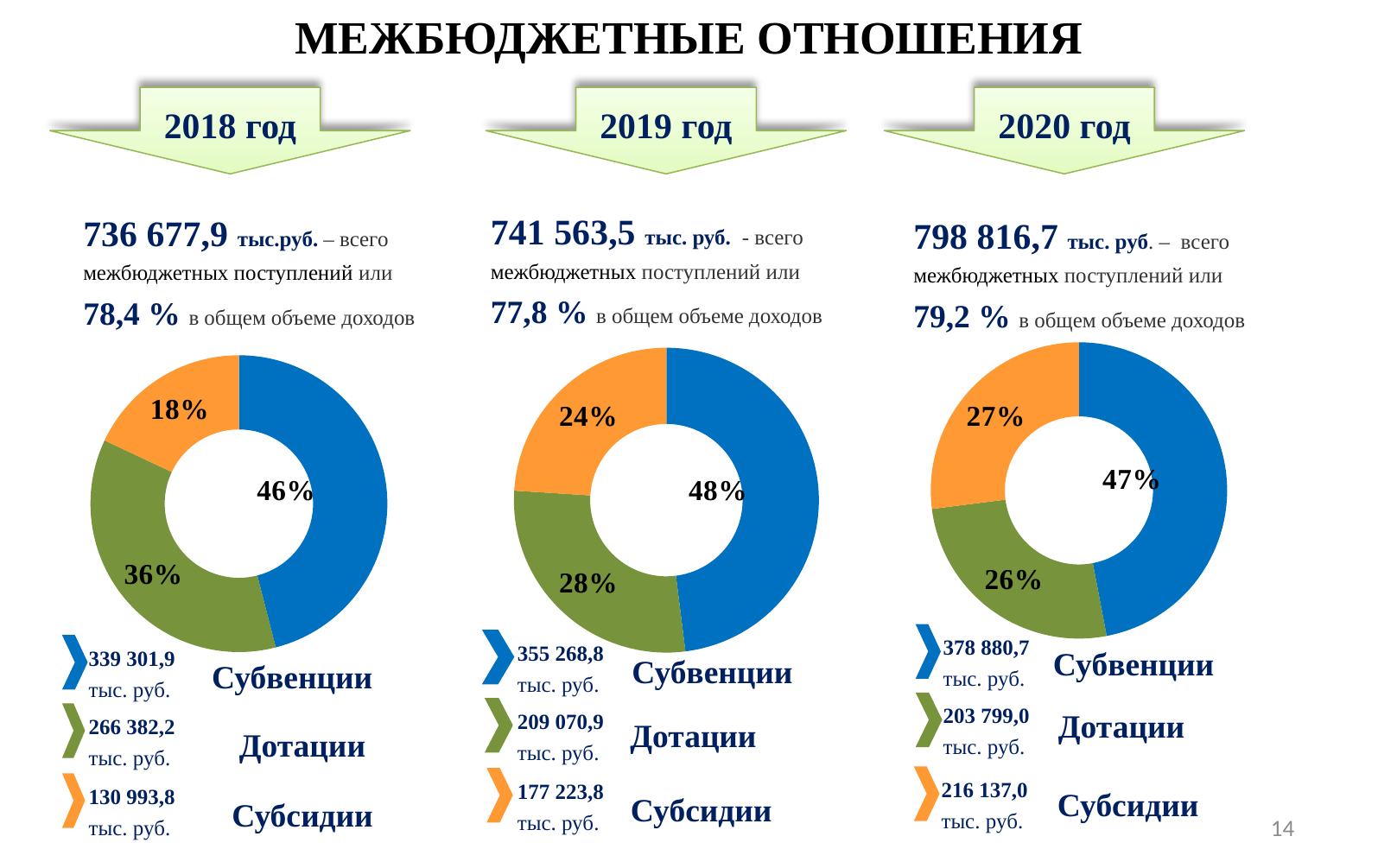
In the 2020 год chart, which category has the largest share? Субвенции How many slices does the 2019 год doughnut chart have? 3 In the 2020 год chart, what is the difference in percentage points between Субвенции and Дотации? 21 In the 2018 год chart, what share of the doughnut is Субвенции? 46% In the 2019 год chart, which is larger: the share of Дотации or the share of Субсидии? Дотации In the 2018 год chart, what is the difference in percentage points between Дотации and Субсидии? 18 In the 2020 год chart, what percentage is shown for Субсидии? 27% How many categories are listed in the legend below the 2020 год chart? 3 In the 2018 год chart, what colour represents Дотации? Green In the 2019 год chart, what percentage is shown for Дотации? 28% What type of chart is used for the 2020 год data? Doughnut chart In the 2018 год chart, which category has the smallest share? Субсидии